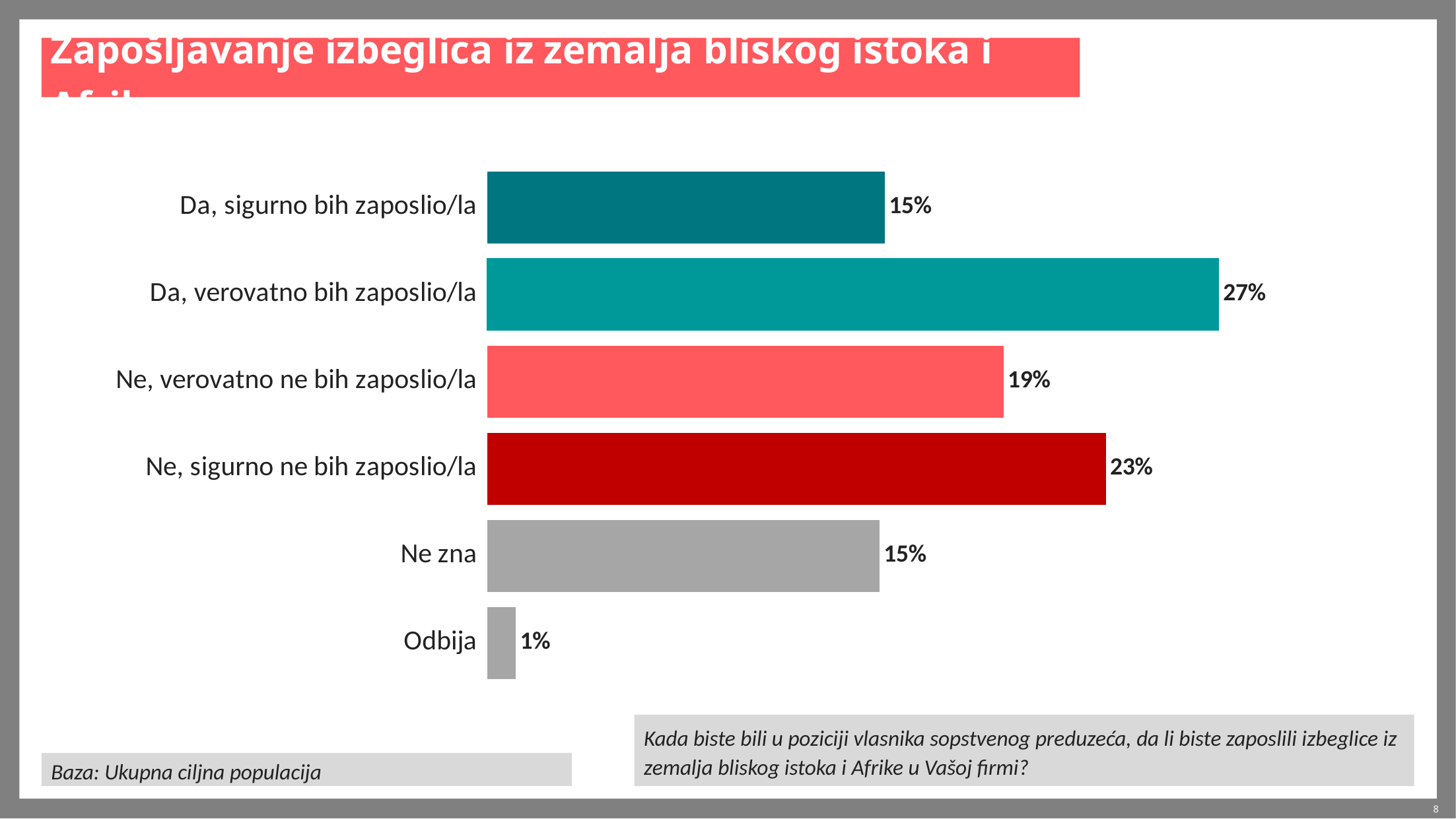
What is the difference between "Da, verovatno bih zaposlio/la" and "Ne, sigurno ne bih zaposlio/la"? 4% What is the value for "Ne, sigurno ne bih zaposlio/la"? 23% What colour is the bar for "Ne zna"? Grey What is the value for "Odbija"? 1% What is the value for "Ne, verovatno ne bih zaposlio/la"? 19% What is the value for "Da, sigurno bih zaposlio/la"? 15% Which is larger: "Ne, verovatno ne bih zaposlio/la" or "Ne, sigurno ne bih zaposlio/la"? Ne, sigurno ne bih zaposlio/la How many categories are shown in the chart? 6 What kind of chart is shown on the slide? Bar chart Which category has the highest value? Da, verovatno bih zaposlio/la What is the value for "Da, verovatno bih zaposlio/la"? 27% Which category has the lowest value? Odbija